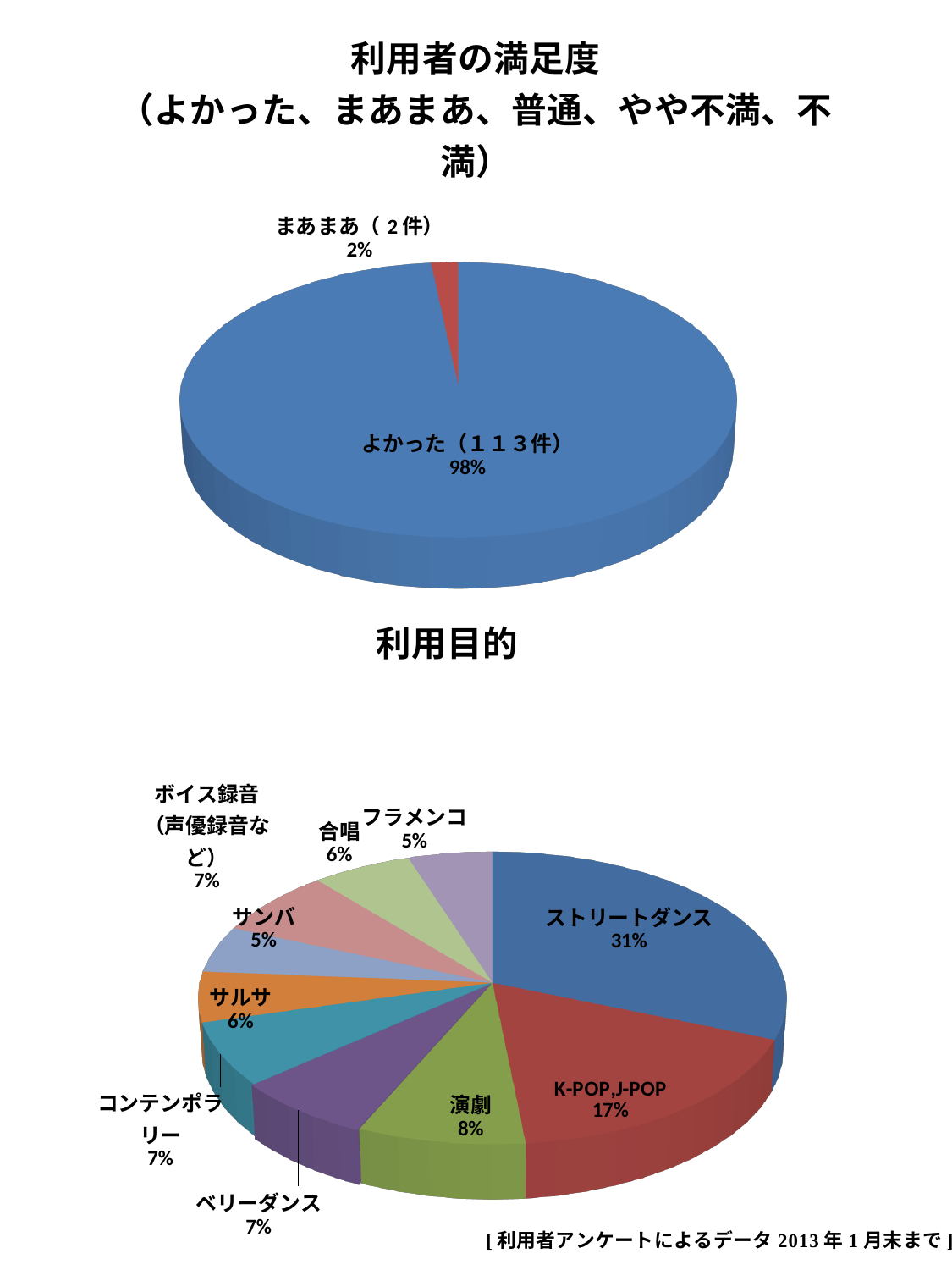
In the top chart (利用者の満足度), what percentage is shown for よかった? 98% In the top chart (利用者の満足度), how many responses (件) are shown for よかった? 113件 In the bottom chart (利用目的), what is the difference in percentage points between ストリートダンス and K-POP,J-POP? 14 In the top chart (利用者の満足度), what is the difference in percentage points between よかった and まあまあ? 96 In the bottom chart (利用目的), which is larger, サルサ or 演劇? 演劇 In the bottom chart (利用目的), which category has the largest share? ストリートダンス What kind of chart is the bottom chart (利用目的)? Pie chart In the bottom chart (利用目的), what percentage is shown for K-POP,J-POP? 17% In the bottom chart (利用目的), what percentage is shown for フラメンコ? 5% In the bottom chart (利用目的), how many categories are shown? 10 In the top chart (利用者の満足度), how many responses (件) are shown for まあまあ? 2件 In the bottom chart (利用目的), what percentage is shown for 演劇? 8%